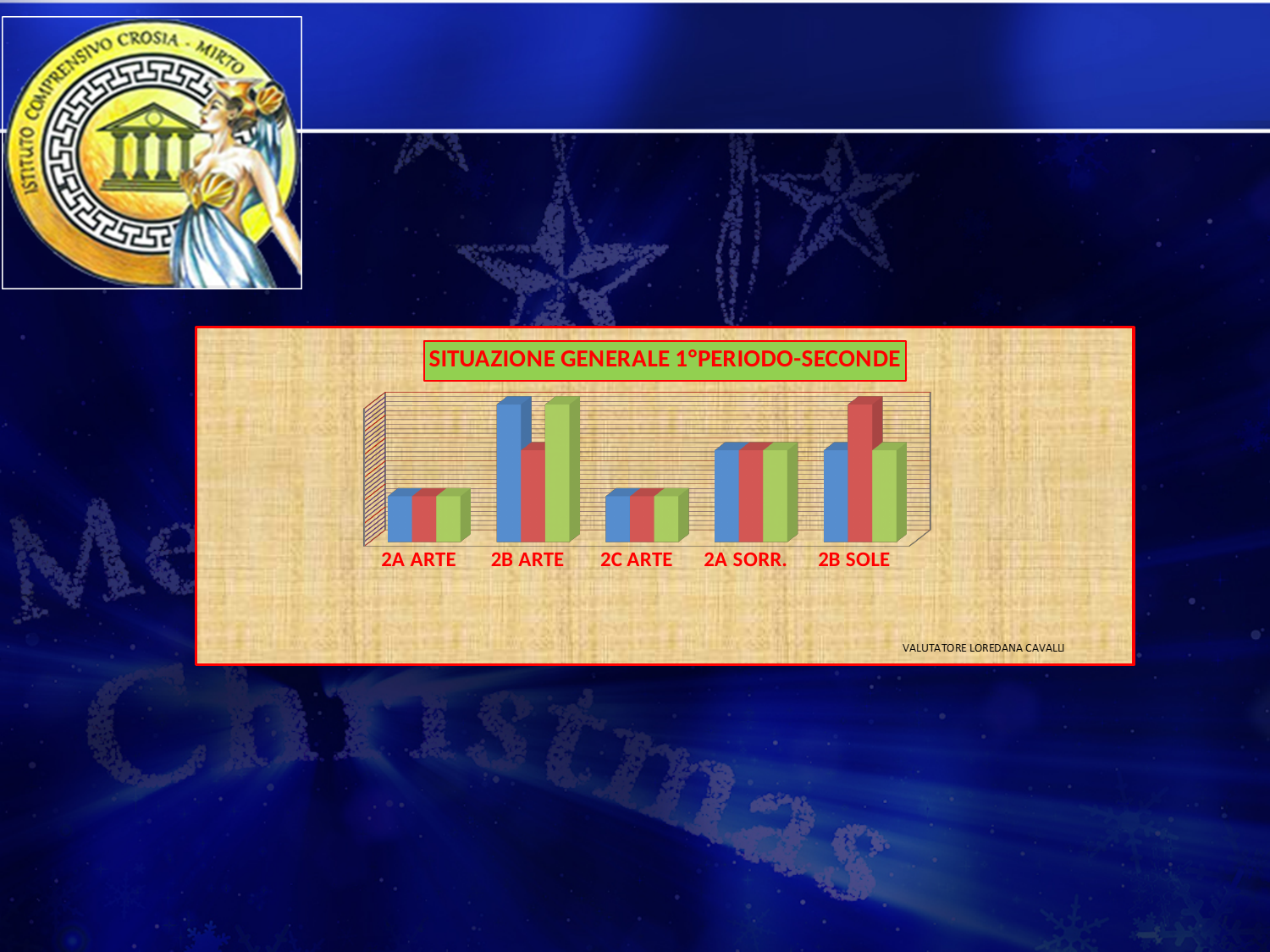
Which category has the tallest blue bar? 2B ARTE How many categories are shown on the x axis of the chart? 5 What kind of chart is shown on the slide? Bar chart Which category has the tallest green bar? 2B ARTE Which has the taller green bar, 2B ARTE or 2A SORR.? 2B ARTE How many bars are plotted for each category in the chart? 3 In the 2B ARTE group, which is taller, the blue bar or the red bar? The blue bar Which category has the tallest red bar? 2B SOLE What is the label of the last category on the x axis? 2B SOLE Which has the taller red bar, 2C ARTE or 2A SORR.? 2A SORR. What is the title of the chart? SITUAZIONE GENERALE 1°PERIODO-SECONDE